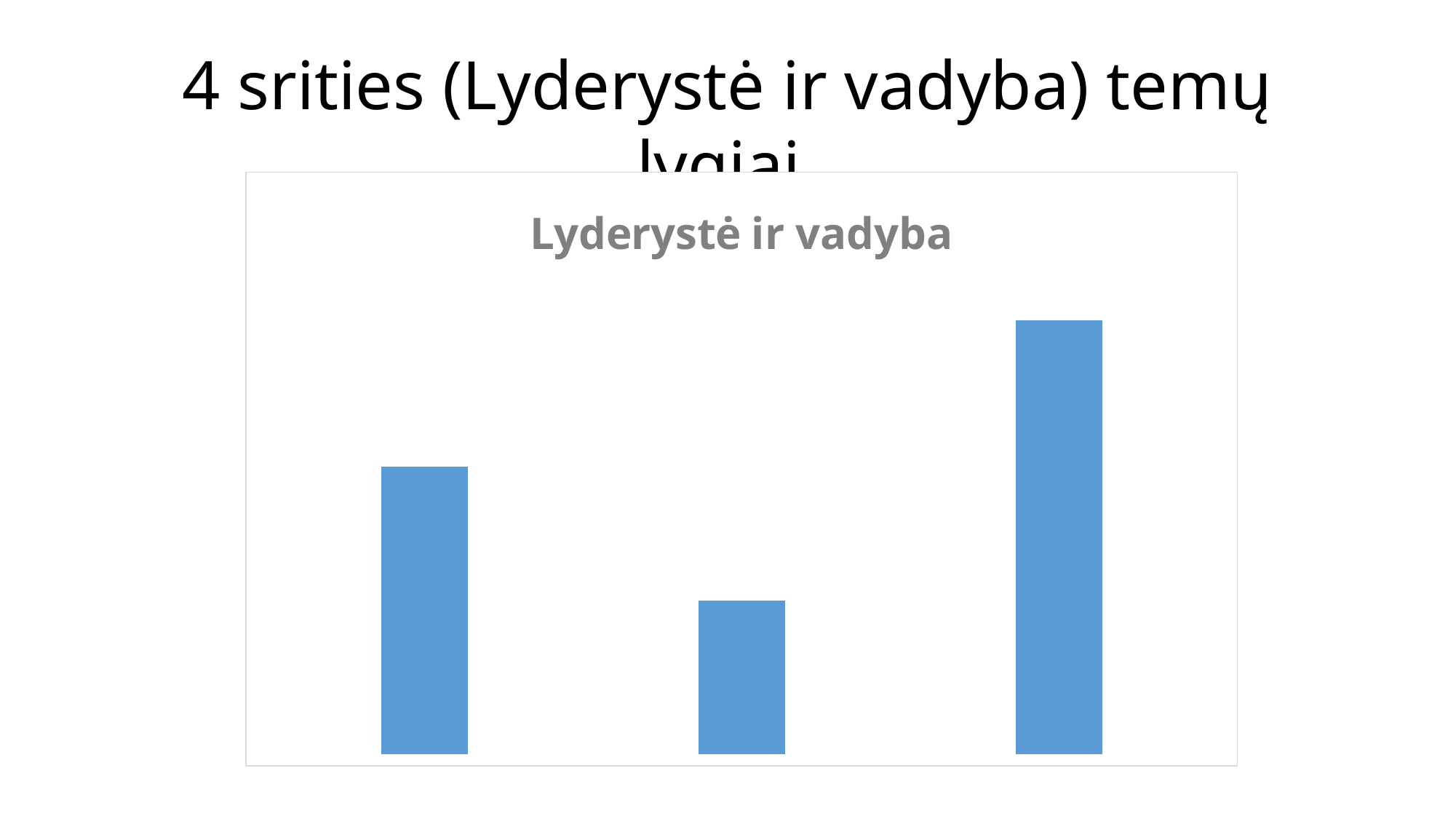
What is the title of the chart? Lyderystė ir vadyba Is the right bar taller or shorter than the left bar? taller Is the left bar taller or shorter than the middle bar? taller Which bar is the shortest: the left, middle, or right one? middle Are the bars in the chart vertical or horizontal? vertical What colour are the bars in the chart? blue How many bars does the chart show? 3 Which bar is the tallest: the left, middle, or right one? right What kind of chart is shown on the slide? bar chart Is the middle bar taller or shorter than the right bar? shorter